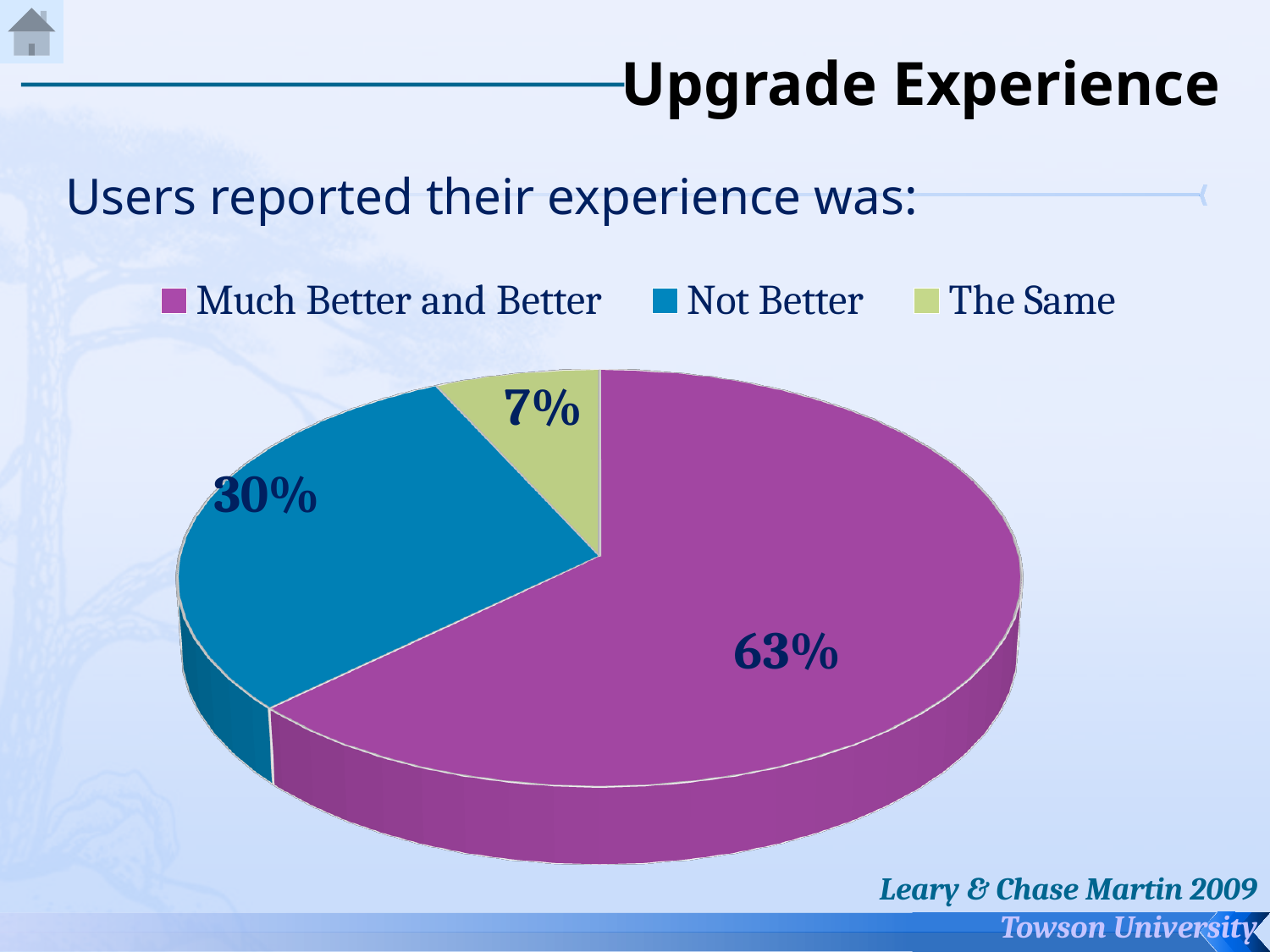
How many percentage points larger is Much Better and Better than Not Better? 33 Which category has the largest share of the pie? Much Better and Better Which is larger, the share for Not Better or the share for The Same? Not Better Which category has the smallest share of the pie? The Same What percentage of users reported their experience was Not Better? 30% What percentage of users reported their experience was The Same? 7% What colour is the slice for Not Better? blue How many percentage points larger is Not Better than The Same? 23 What is the title of the slide containing the chart? Upgrade Experience How many categories does the pie chart have? 3 What percentage of users reported their experience was Much Better and Better? 63% What kind of chart is shown on the slide? pie chart